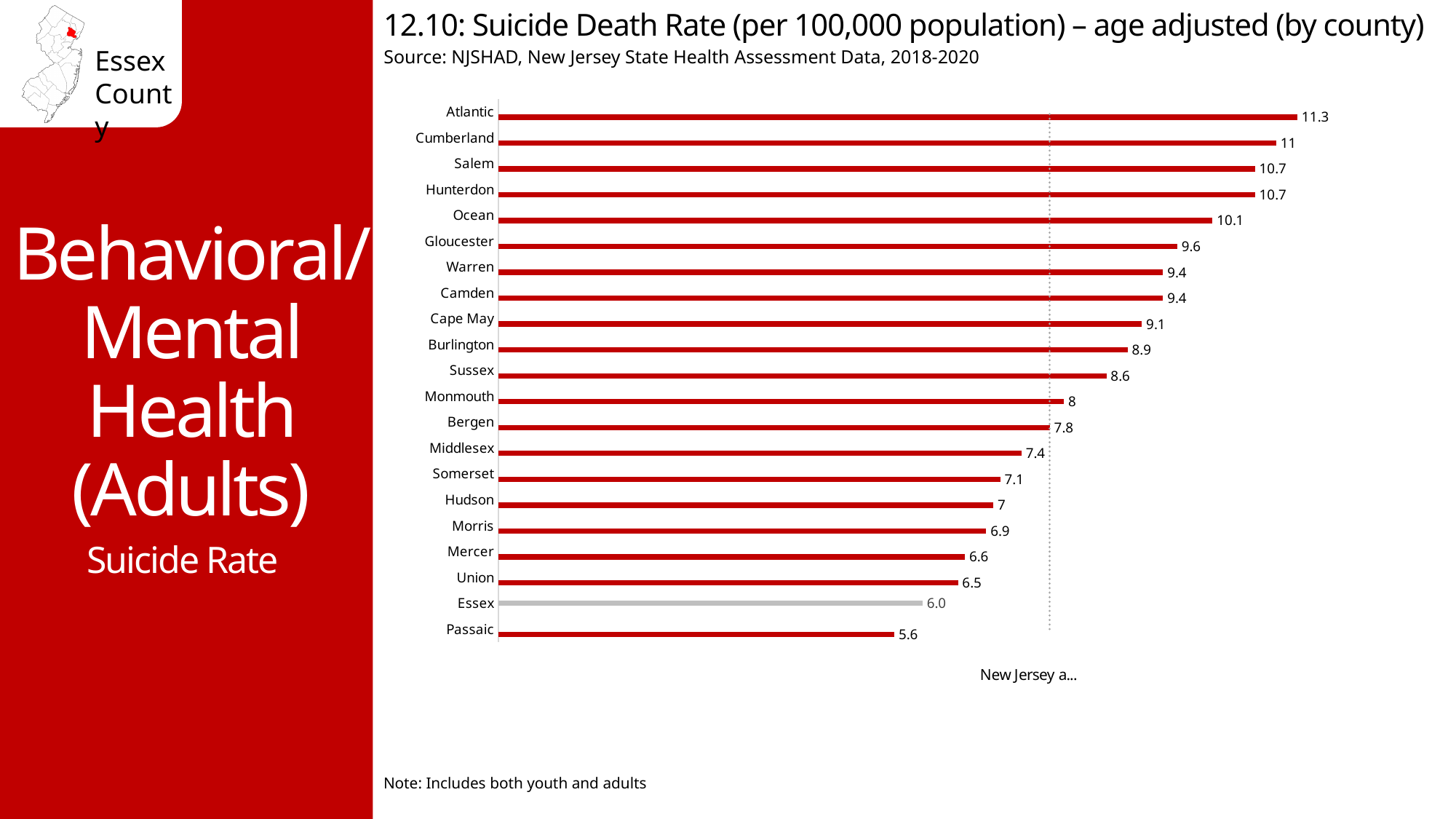
Which county has the highest suicide death rate? Atlantic What is the suicide death rate for Atlantic County? 11.3 What is the suicide death rate for Bergen County? 7.8 What is the difference between the suicide death rates of Atlantic and Passaic counties? 5.7 Which county has a higher suicide death rate, Hudson or Mercer? Hudson Which county has the lowest suicide death rate? Passaic What is the difference between the suicide death rates of Union and Essex counties? 0.5 What type of chart is shown on the slide? Bar chart Which county's bar is shown in grey instead of red? Essex What is the suicide death rate for Essex County? 6.0 Which county has a higher suicide death rate, Ocean or Gloucester? Ocean How many counties are shown in the chart? 21